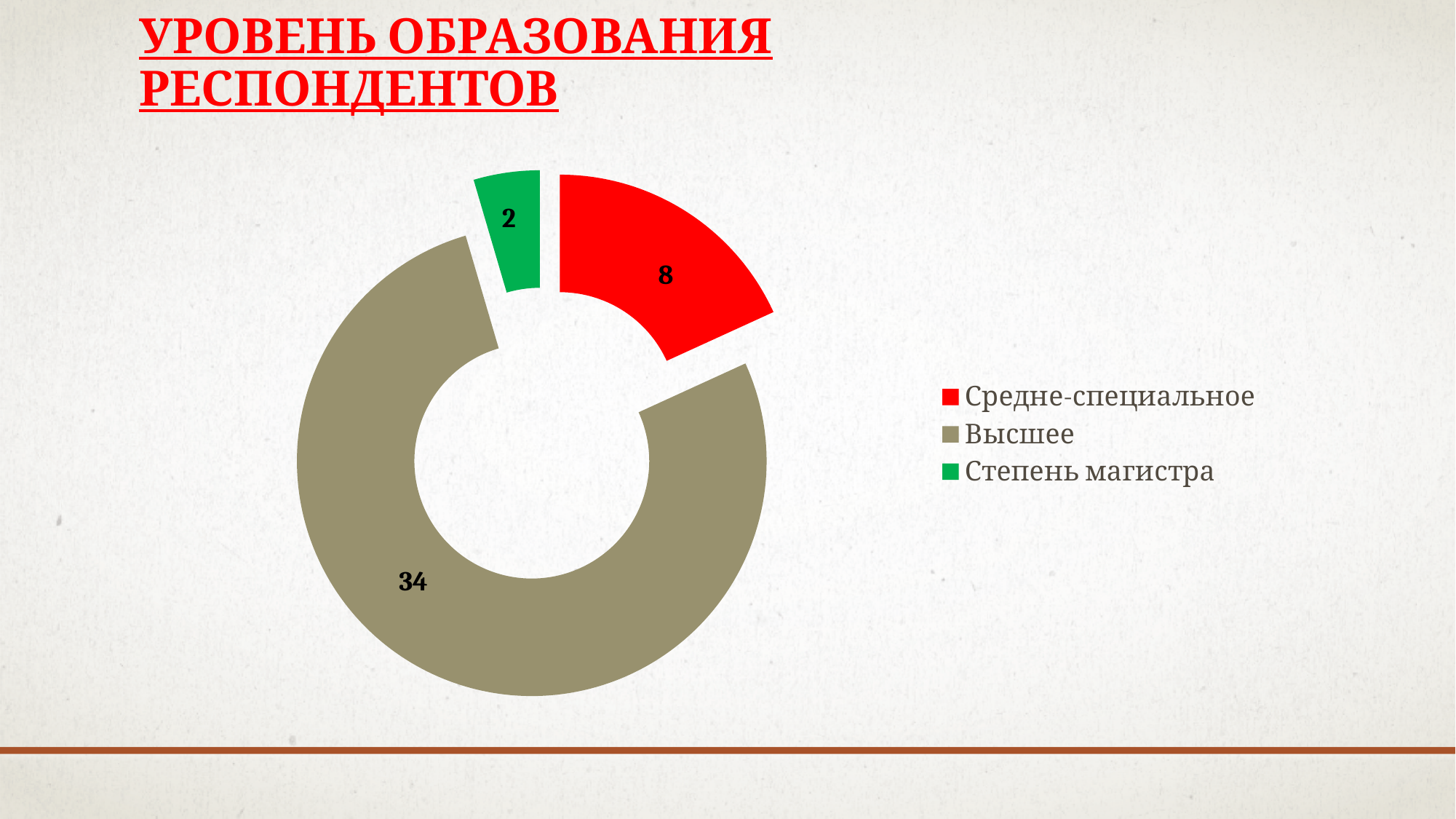
What is the difference between the values for Высшее and Средне-специальное? 26 Which category has the highest value? Высшее What is the value for Средне-специальное? 8 What is the value for Высшее? 34 What is the difference between the values for Средне-специальное and Степень магистра? 6 Which is larger, the value for Средне-специальное or the value for Степень магистра? Средне-специальное How many categories does the chart show? 3 Which colour represents Степень магистра in the legend? green What kind of chart is shown on the slide? doughnut chart Which category has the lowest value? Степень магистра What is the title of the slide? УРОВЕНЬ ОБРАЗОВАНИЯ РЕСПОНДЕНТОВ What is the value for Степень магистра? 2